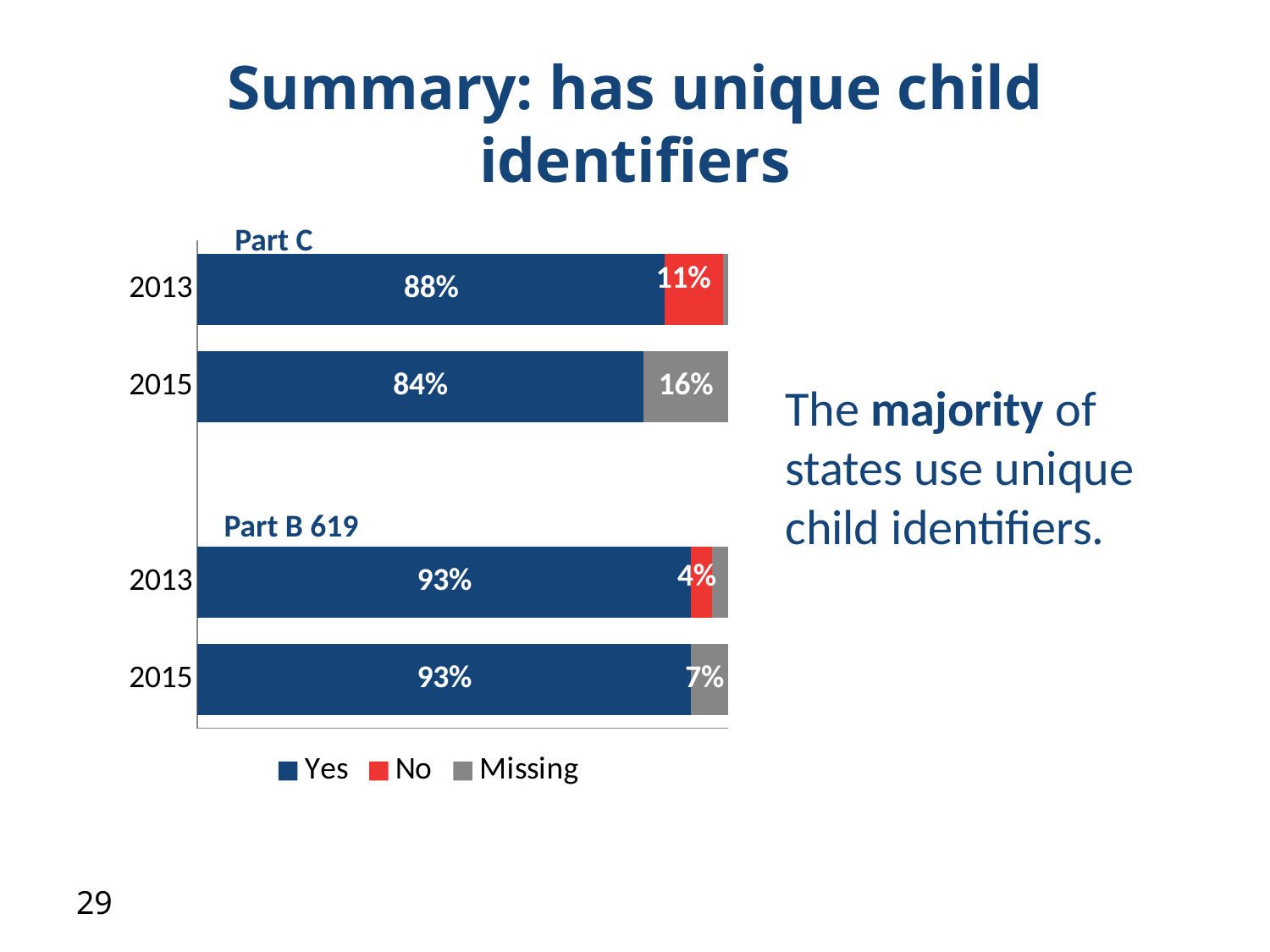
What is the No percentage for Part C in 2013? 11% What is the No percentage for Part B 619 in 2013? 4% What percentage of states answered Yes for Part B 619 in 2013? 93% What is the Missing percentage for Part B 619 in 2015? 7% Which colour represents the No responses in the chart? Red What kind of chart is shown on the slide? Stacked bar chart What percentage of states answered Yes for Part C in 2013? 88% By how many percentage points did the Yes share for Part C change from 2013 to 2015? 4 percentage points (decreased from 88% to 84%) What percentage of states answered Yes for Part C in 2015? 84% What is the Missing percentage for Part C in 2015? 16% Which has a larger Yes share in 2015, Part C or Part B 619? Part B 619 How many series does the legend list? 3